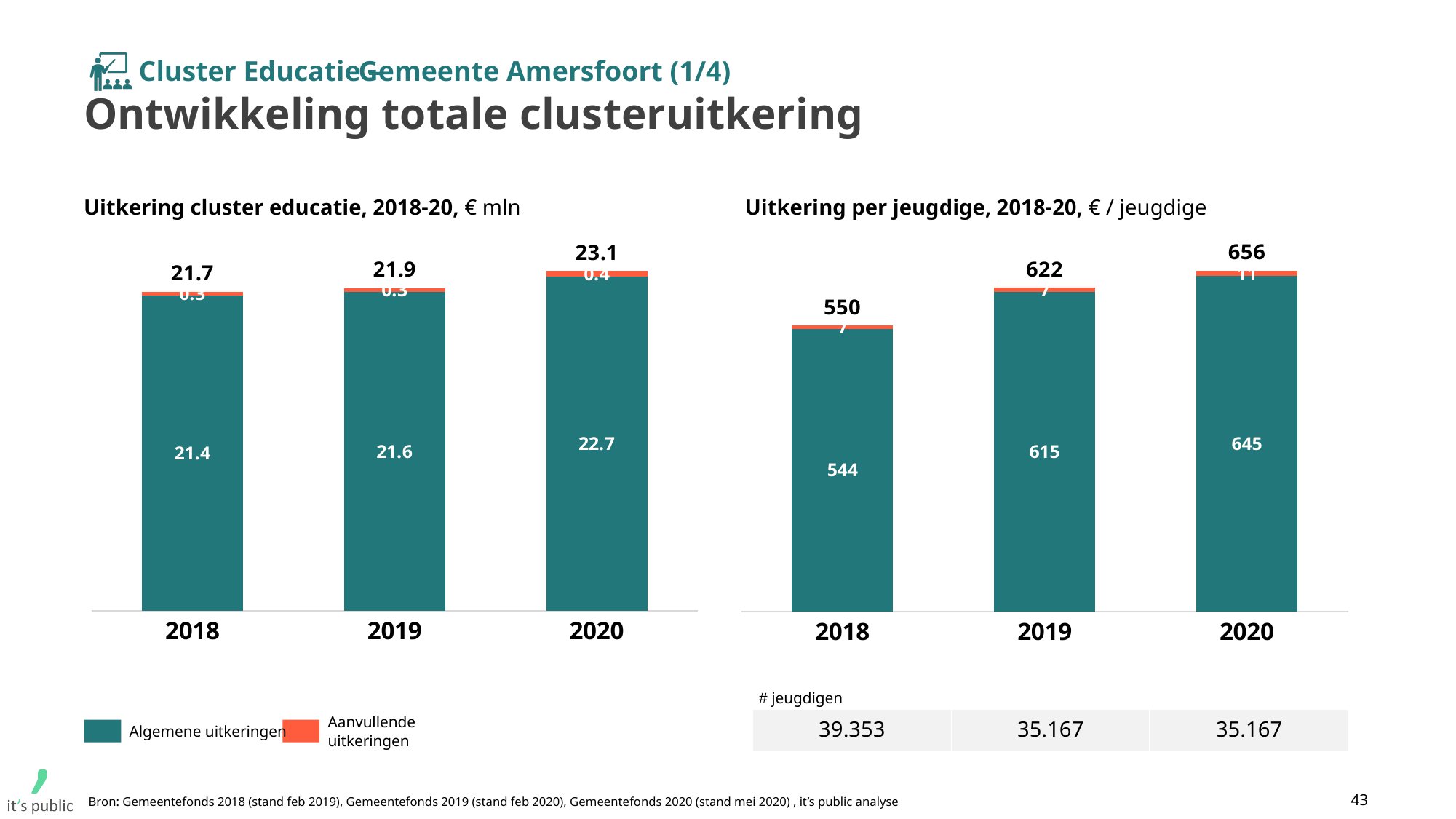
In the chart 'Uitkering per jeugdige, 2018-20', do the totals rise or fall from 2018 to 2020? rise What type of chart is 'Uitkering cluster educatie, 2018-20'? stacked bar chart In the chart 'Uitkering cluster educatie, 2018-20', what is the value of Aanvullende uitkeringen for 2020? 0.4 In the chart 'Uitkering cluster educatie, 2018-20', what is the difference between the totals for 2020 and 2018? 1.4 How many series does the legend list for the chart 'Uitkering cluster educatie, 2018-20'? 2 In the chart 'Uitkering per jeugdige, 2018-20', what is the difference between the totals for 2020 and 2018? 106 In the chart 'Uitkering cluster educatie, 2018-20', which year has the highest total? 2020 In the chart 'Uitkering per jeugdige, 2018-20', what is the value of Algemene uitkeringen for 2020? 645 In the chart 'Uitkering cluster educatie, 2018-20', what is the total value for 2020? 23.1 In the chart 'Uitkering per jeugdige, 2018-20', what is the total value for 2019? 622 In the chart 'Uitkering cluster educatie, 2018-20', what is the value of Algemene uitkeringen for 2018? 21.4 In the chart 'Uitkering per jeugdige, 2018-20', which year has the lowest total? 2018